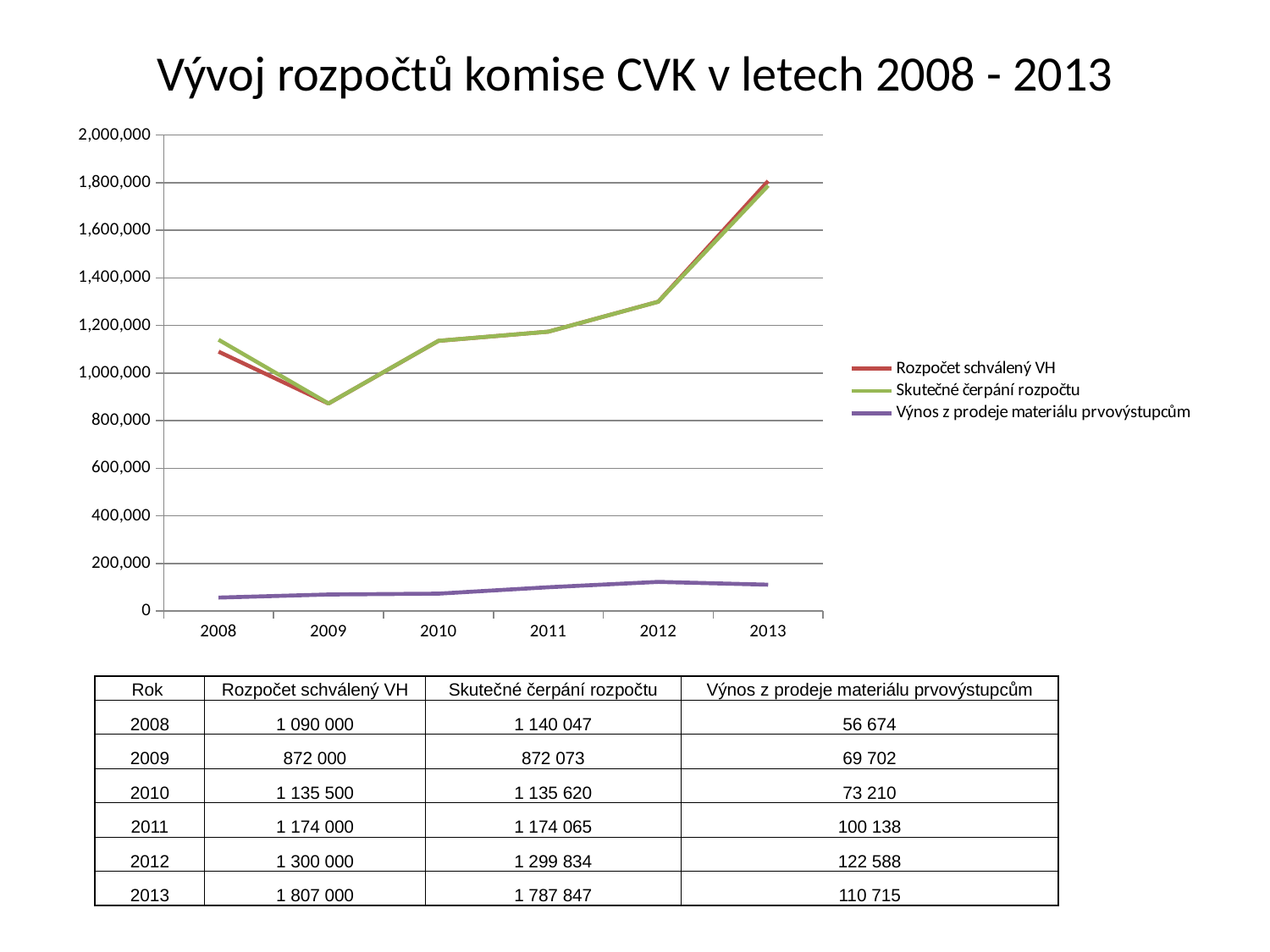
What is the value of Rozpočet schválený VH for 2013? 1 807 000 What is the value of Skutečné čerpání rozpočtu for 2008? 1 140 047 Is the value of Výnos z prodeje materiálu prvovýstupcům for 2013 greater or less than 200,000? less What is the difference between Rozpočet schválený VH and Skutečné čerpání rozpočtu in 2013? 19 153 In which year is Rozpočet schválený VH the highest? 2013 In which year is Skutečné čerpání rozpočtu the lowest? 2009 How many series does the chart legend list? 3 How many years are plotted along the x axis of the chart? 6 Does Rozpočet schválený VH rise or fall from 2009 to 2013? rises What kind of chart is shown on the slide? line chart In 2008, which is larger: Rozpočet schválený VH or Skutečné čerpání rozpočtu? Skutečné čerpání rozpočtu What is the value of Výnos z prodeje materiálu prvovýstupcům for 2012? 122 588